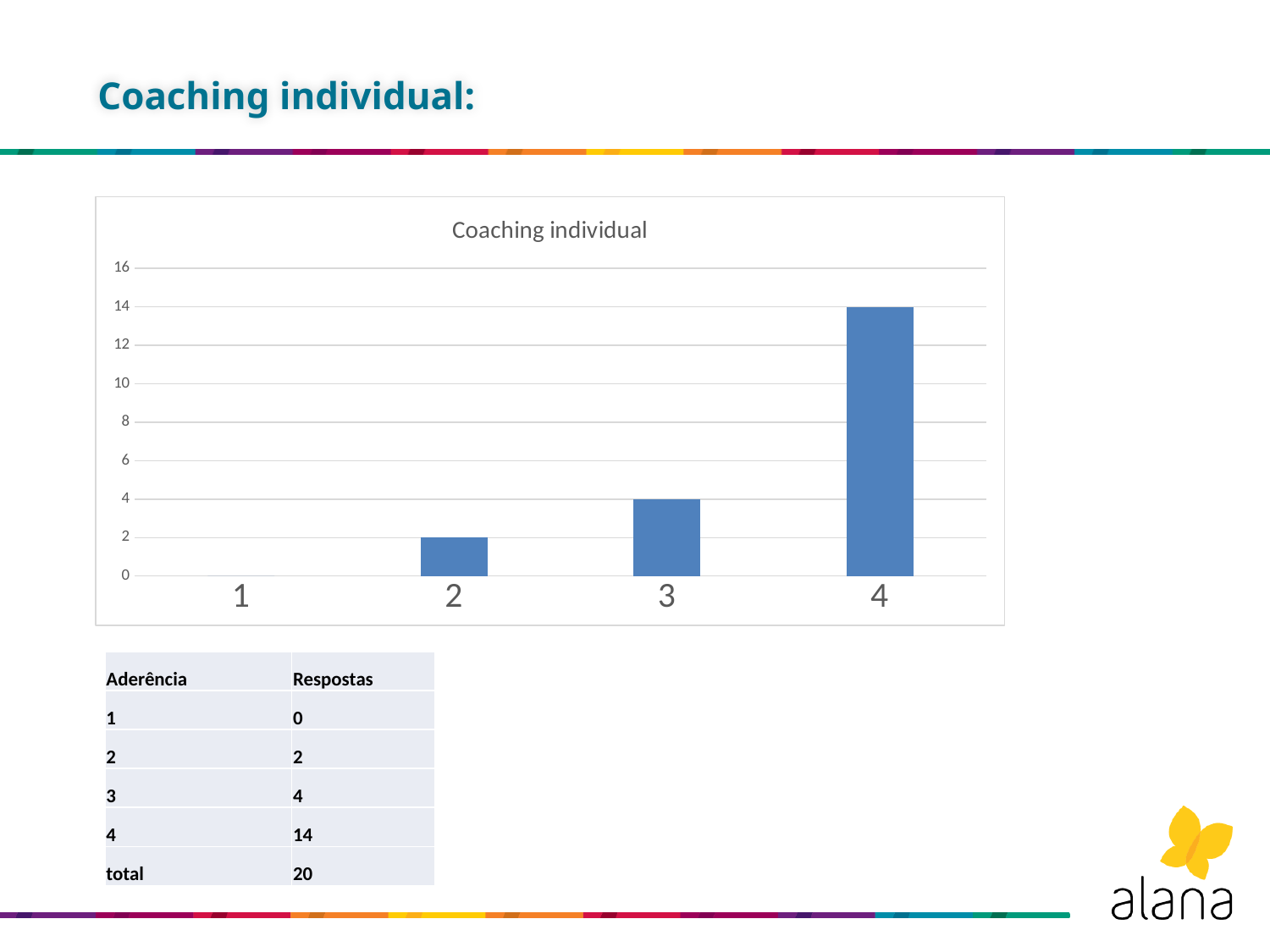
Which category has the lowest value in the chart? 1 What kind of chart is shown on the slide? bar chart What is the value for category 4 in the chart? 14 Which category has the highest value in the chart? 4 What is the difference between the values for category 4 and category 3? 10 What is the value for category 3 in the chart? 4 What is the value for category 1 in the chart? 0 What is the value for category 2 in the chart? 2 How many categories are shown on the x axis of the chart? 4 What is the title of the chart? Coaching individual Which is larger, the value for category 2 or the value for category 3? 3 Do the values rise or fall from category 1 to category 4 along the x axis? rise